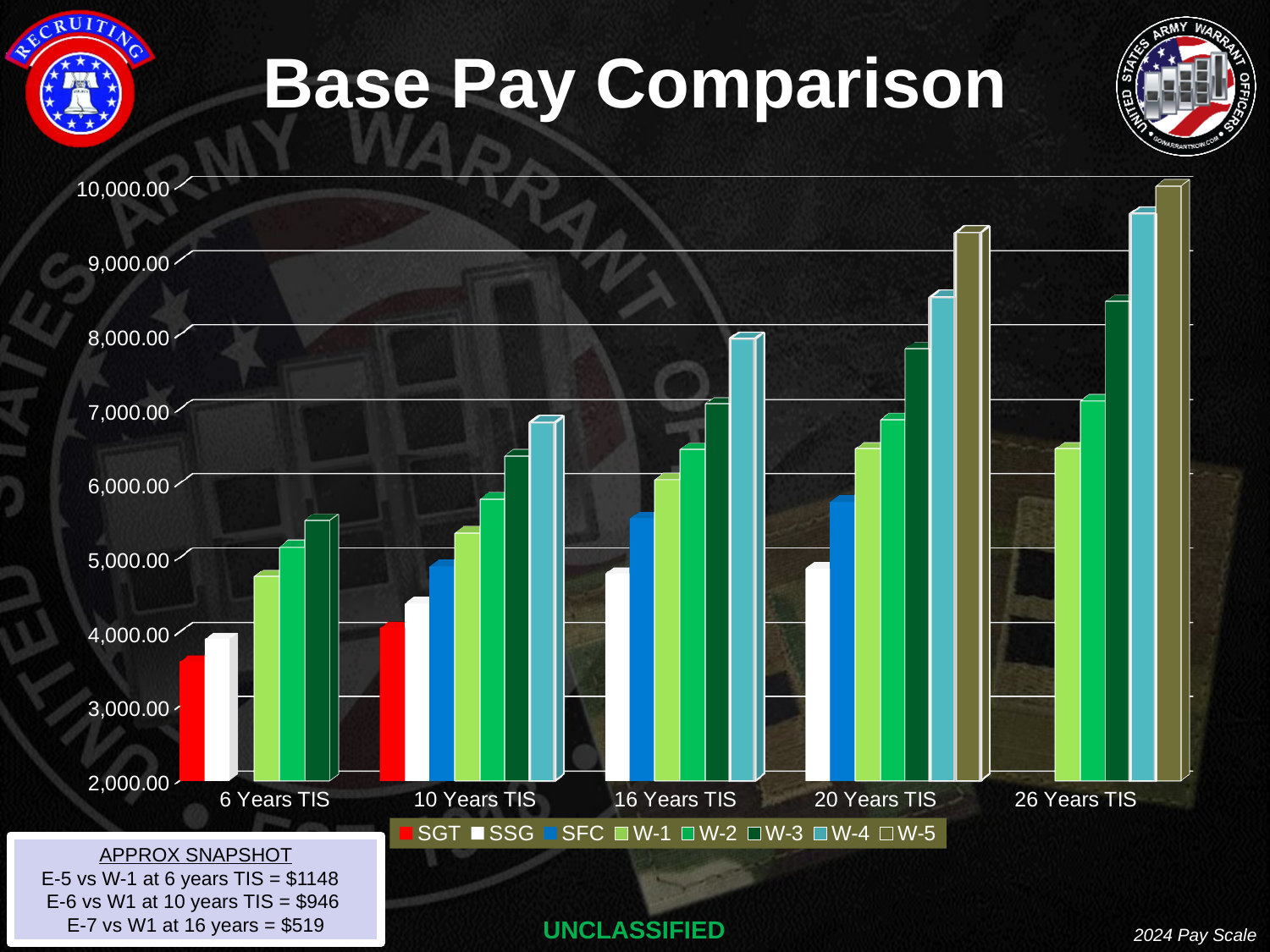
How many series does the chart legend list? 8 How many Years TIS categories are shown on the x axis? 5 Is the value for W-4 at 16 Years TIS greater or less than 7,000.00? greater Which series has the tallest bar in the 26 Years TIS category? W-5 What is the title of the chart? Base Pay Comparison What type of chart is shown on the slide? Bar chart At 16 Years TIS, which is larger, the W-3 bar or the W-4 bar? W-4 Which series has the shortest bar in the 6 Years TIS category? SGT Is the value for W-5 at 20 Years TIS greater or less than 9,000.00? greater Do the W-1 values rise or fall as Years TIS increases along the x axis? Rise Is the value for SGT at 6 Years TIS greater or less than 4,000.00? less What colour is used for the SGT series in the chart? Red